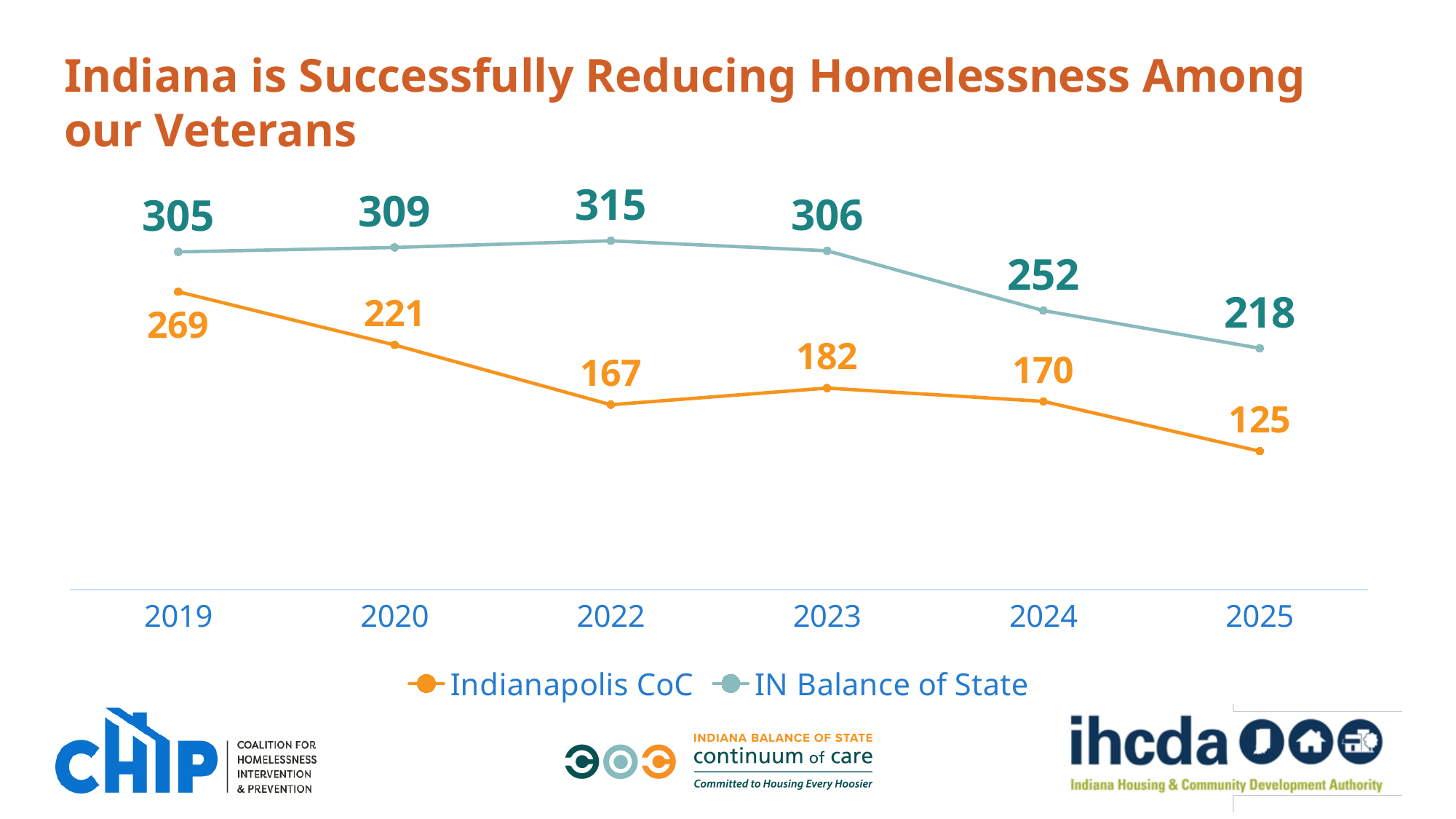
What is the value for Indianapolis CoC in 2025? 125 In which year is the IN Balance of State value highest? 2022 What kind of chart is shown on the slide? Line chart How many years are shown on the x axis? 6 Which colour is used for the Indianapolis CoC series? Orange How many series does the legend list? 2 In which year is the Indianapolis CoC value lowest? 2025 Does the IN Balance of State series rise or fall between 2023 and 2025? Fall What is the value for IN Balance of State in 2022? 315 What is the value for Indianapolis CoC in 2019? 269 Which series has the larger value in 2023, Indianapolis CoC or IN Balance of State? IN Balance of State What is the difference between IN Balance of State and Indianapolis CoC in 2025? 93